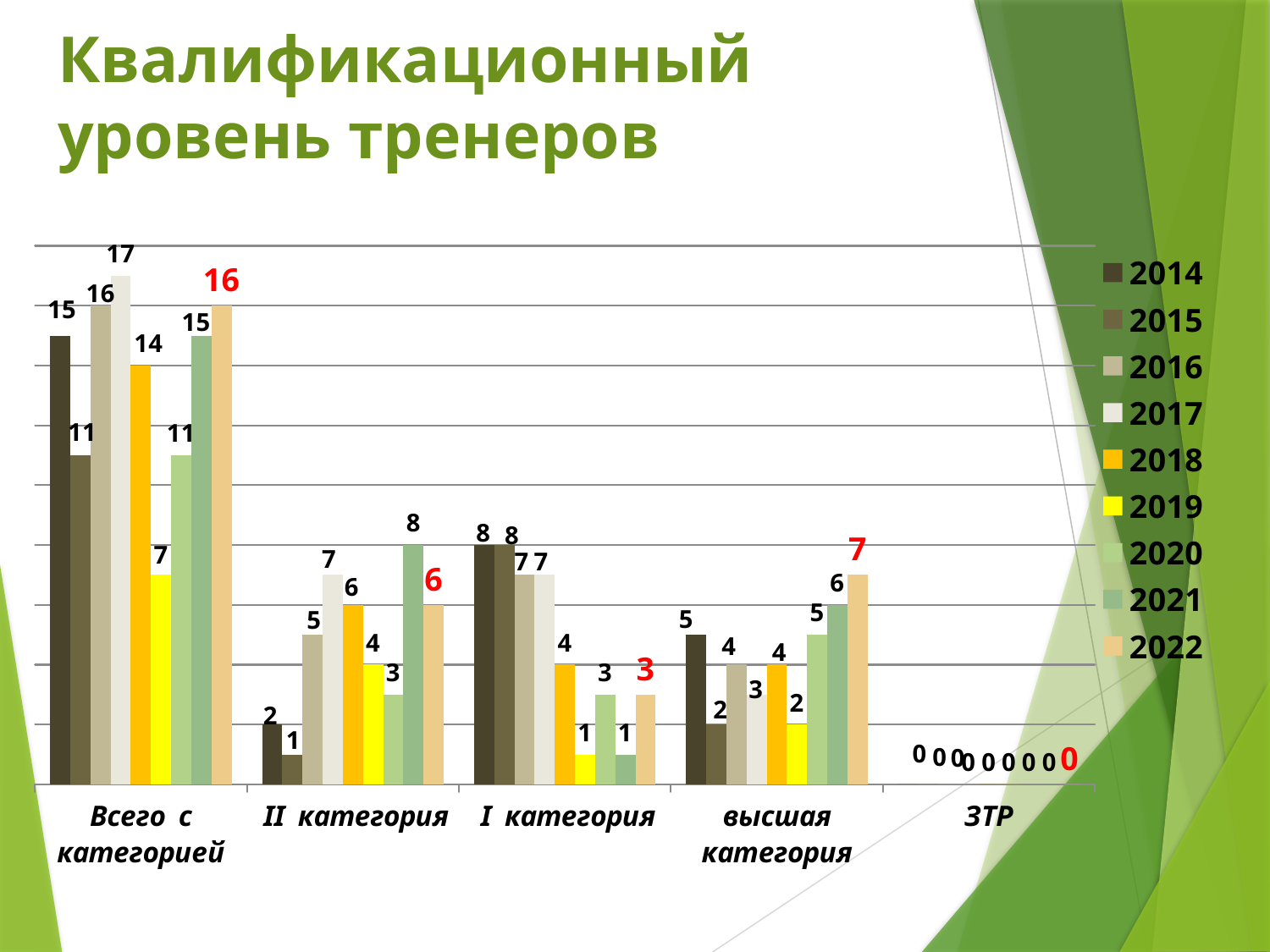
What is the value for every year in the 'ЗТР' category? 0 Which year has the highest value in the 'Всего с категорией' category? 2017 What is the value for 2022 in the 'Всего с категорией' category? 16 Which year has the lowest value in the 'II категория' category? 2015 What is the value for 2019 in the 'Всего с категорией' category? 7 How many series does the legend list? 9 What is the value for 2022 in the 'высшая категория' category? 7 How many categories are shown on the x axis? 5 What kind of chart is shown on the slide? bar chart What is the value for 2021 in the 'II категория' category? 8 Which is larger in the 'высшая категория' category: the value for 2014 or the value for 2022? 2022 What is the difference between the 2014 and 2022 values in the 'I категория' category? 5